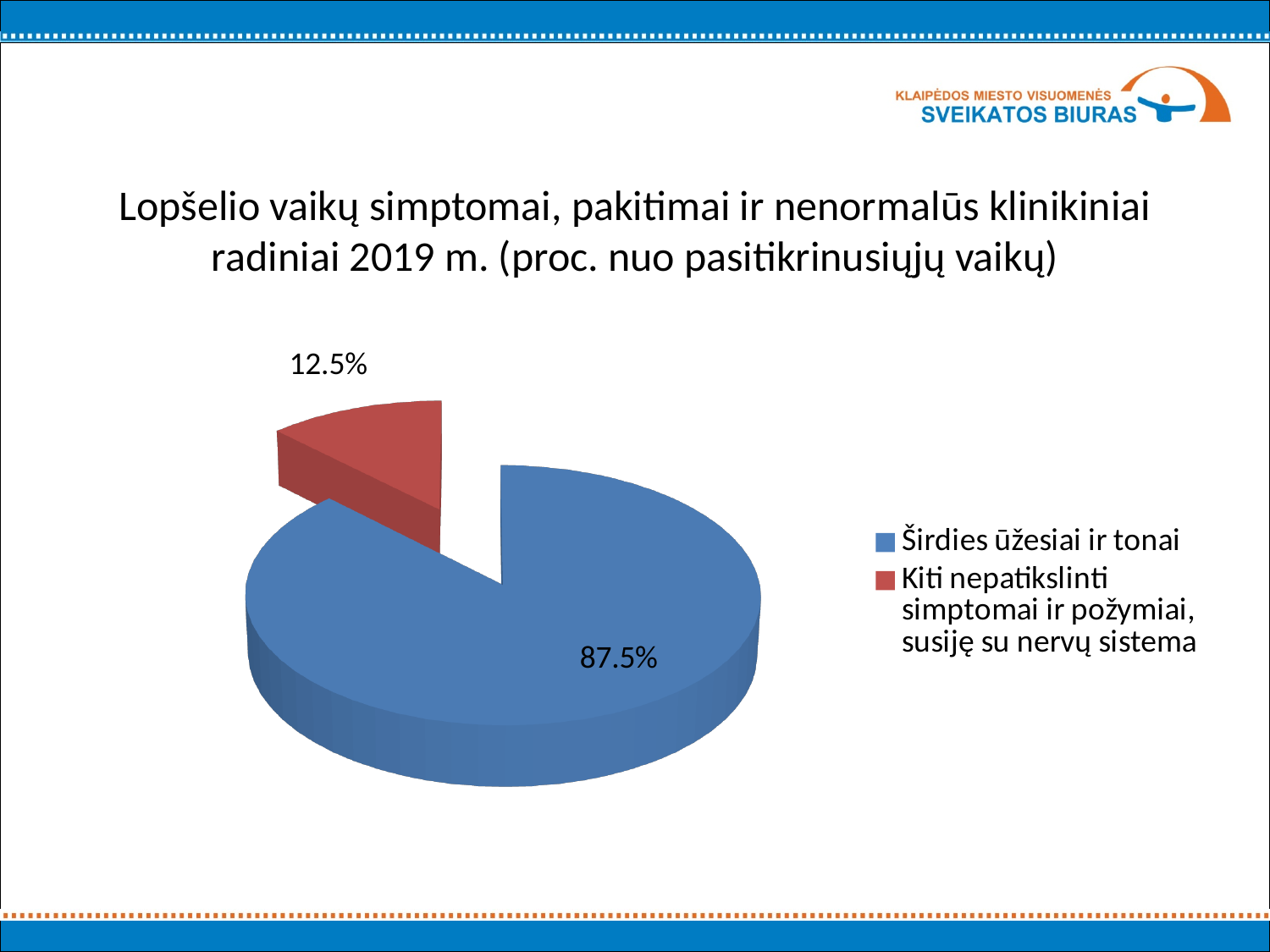
What year does the chart title refer to? 2019 How many entries does the legend list? 2 What percentage is shown for "Širdies ūžesiai ir tonai"? 87.5% Which is larger: the share for "Širdies ūžesiai ir tonai" or the share for "Kiti nepatikslinti simptomai ir požymiai, susiję su nervų sistema"? Širdies ūžesiai ir tonai What kind of chart is shown on the slide? Pie chart What colour is the slice for "Kiti nepatikslinti simptomai ir požymiai, susiję su nervų sistema"? Red What is the difference in percentage points between "Širdies ūžesiai ir tonai" and "Kiti nepatikslinti simptomai ir požymiai, susiję su nervų sistema"? 75 percentage points What percentage is shown for "Kiti nepatikslinti simptomai ir požymiai, susiję su nervų sistema"? 12.5% Which category has the largest share of the pie? Širdies ūžesiai ir tonai Which category has the smallest share of the pie? Kiti nepatikslinti simptomai ir požymiai, susiję su nervų sistema How many slices does the pie chart have? 2